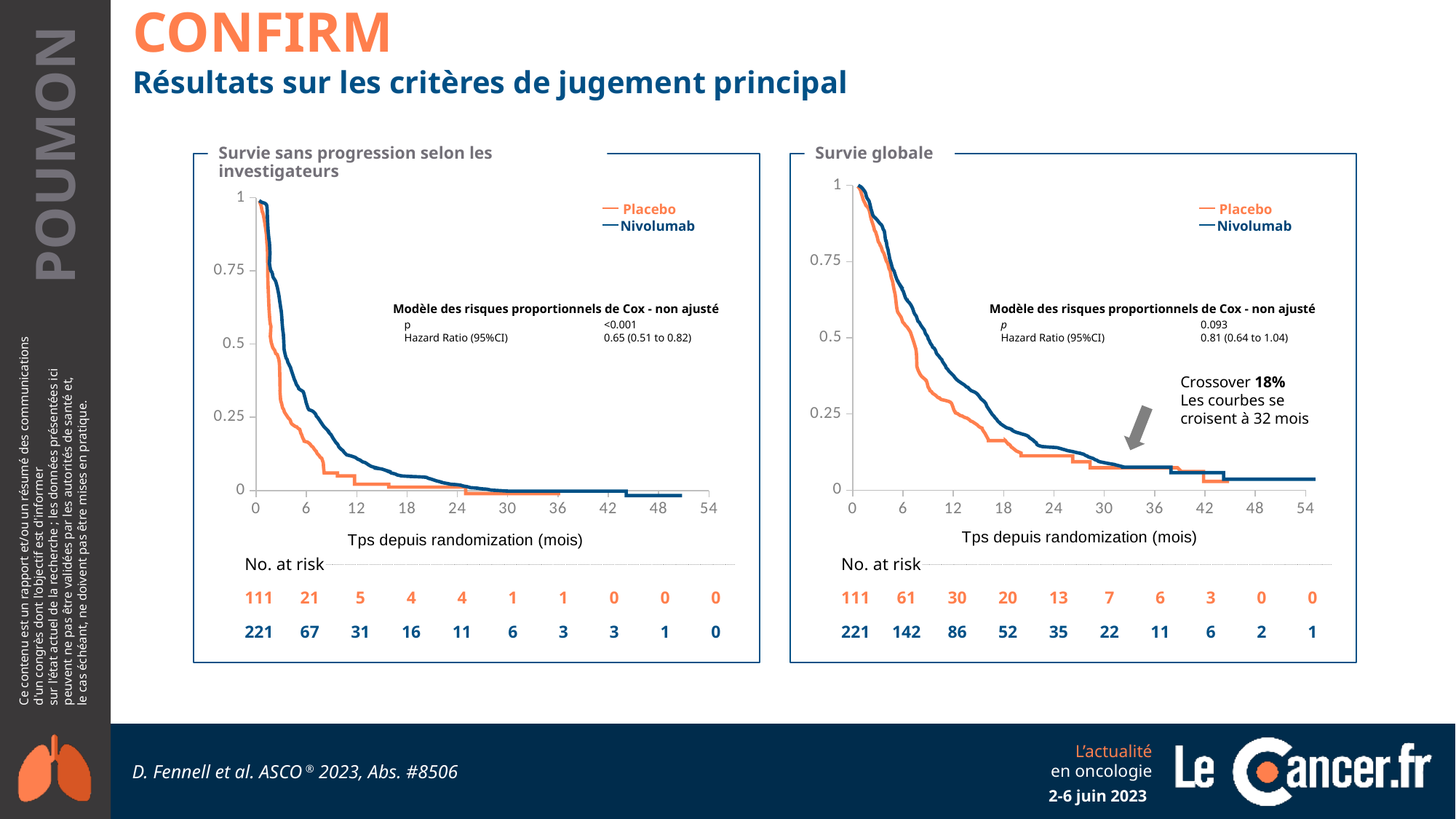
In the 'Survie globale' chart, is the Placebo survival probability at 6 months greater or less than 0.5? greater In the 'Survie globale' chart, how many Nivolumab patients are at risk at 6 months? 142 In the 'Survie sans progression selon les investigateurs' chart, how many Placebo patients are at risk at 12 months? 5 In the 'Survie globale' chart, at how many months do the curves cross according to the annotation? 32 mois In the 'Survie globale' chart, which group has more patients at risk at 12 months, Nivolumab or Placebo? Nivolumab In the 'Survie globale' chart, which colour represents the Nivolumab series? Blue What kind of chart is the 'Survie globale' chart? Line chart (Kaplan-Meier survival curves) In the 'Survie globale' chart, what is the p value shown for the Cox model? 0.093 In the 'Survie sans progression selon les investigateurs' chart, do the survival curves rise or fall as time since randomization increases? fall How many series does the legend of the 'Survie sans progression selon les investigateurs' chart list? 2 In the 'Survie sans progression selon les investigateurs' chart, what is the Hazard Ratio (95%CI) shown? 0.65 (0.51 to 0.82) In the 'Survie globale' chart, what is the difference between the number of Nivolumab and Placebo patients at risk at 0 months? 110